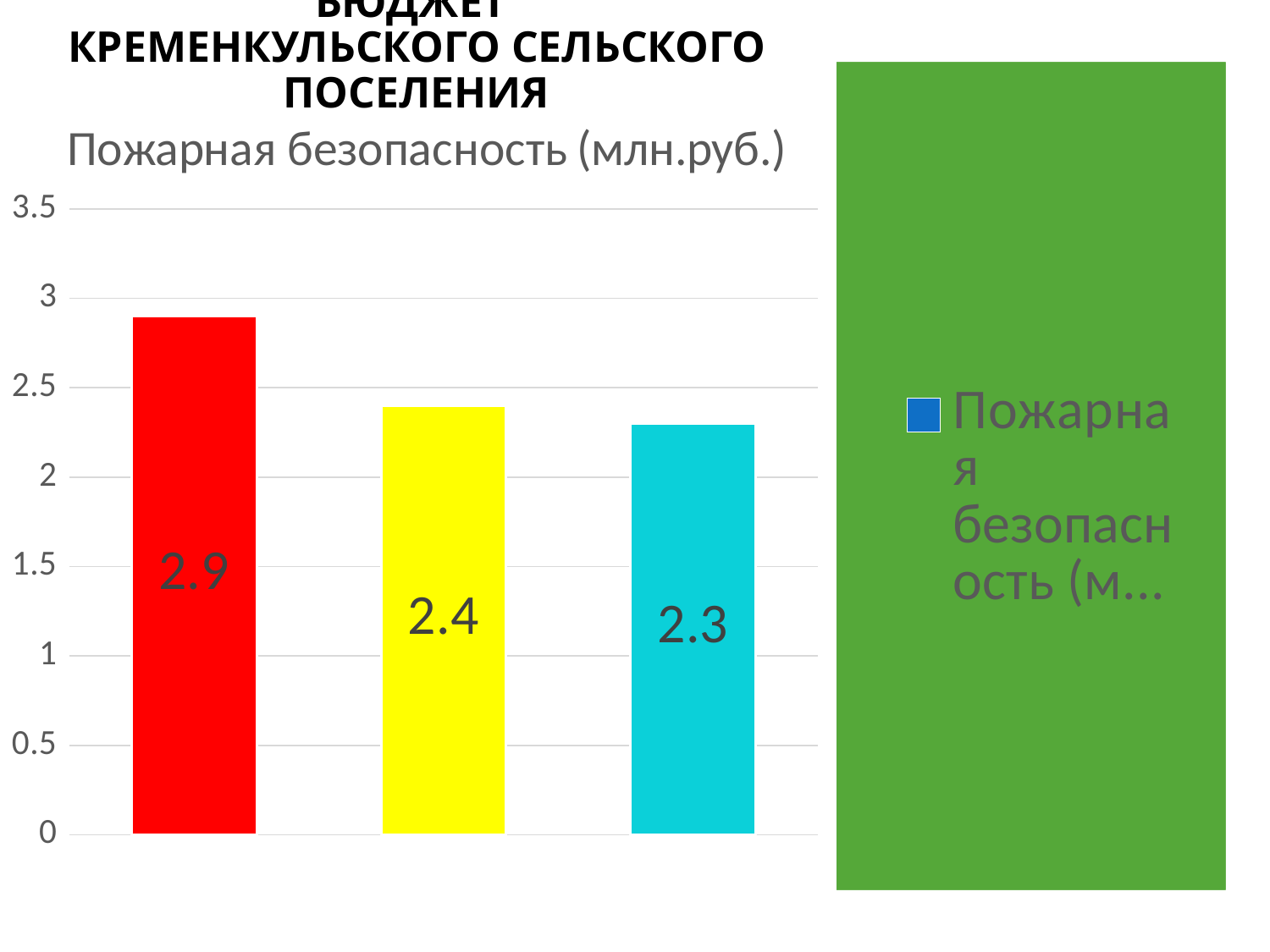
How many bars are plotted in the chart? 3 What is the difference between the red bar and the yellow bar? 0.5 Is the value of the red bar greater or less than 2.5? greater What is the value of the red bar? 2.9 What kind of chart is shown on the slide? bar chart What is the value of the cyan (rightmost) bar? 2.3 Which bar has the highest value? the red bar (2.9) Which bar has the lowest value? the cyan bar (2.3) Do the bar values rise or fall from left to right? fall Which is larger, the red bar or the yellow bar? the red bar What is the value of the yellow bar? 2.4 What is the difference between the red bar and the cyan bar? 0.6